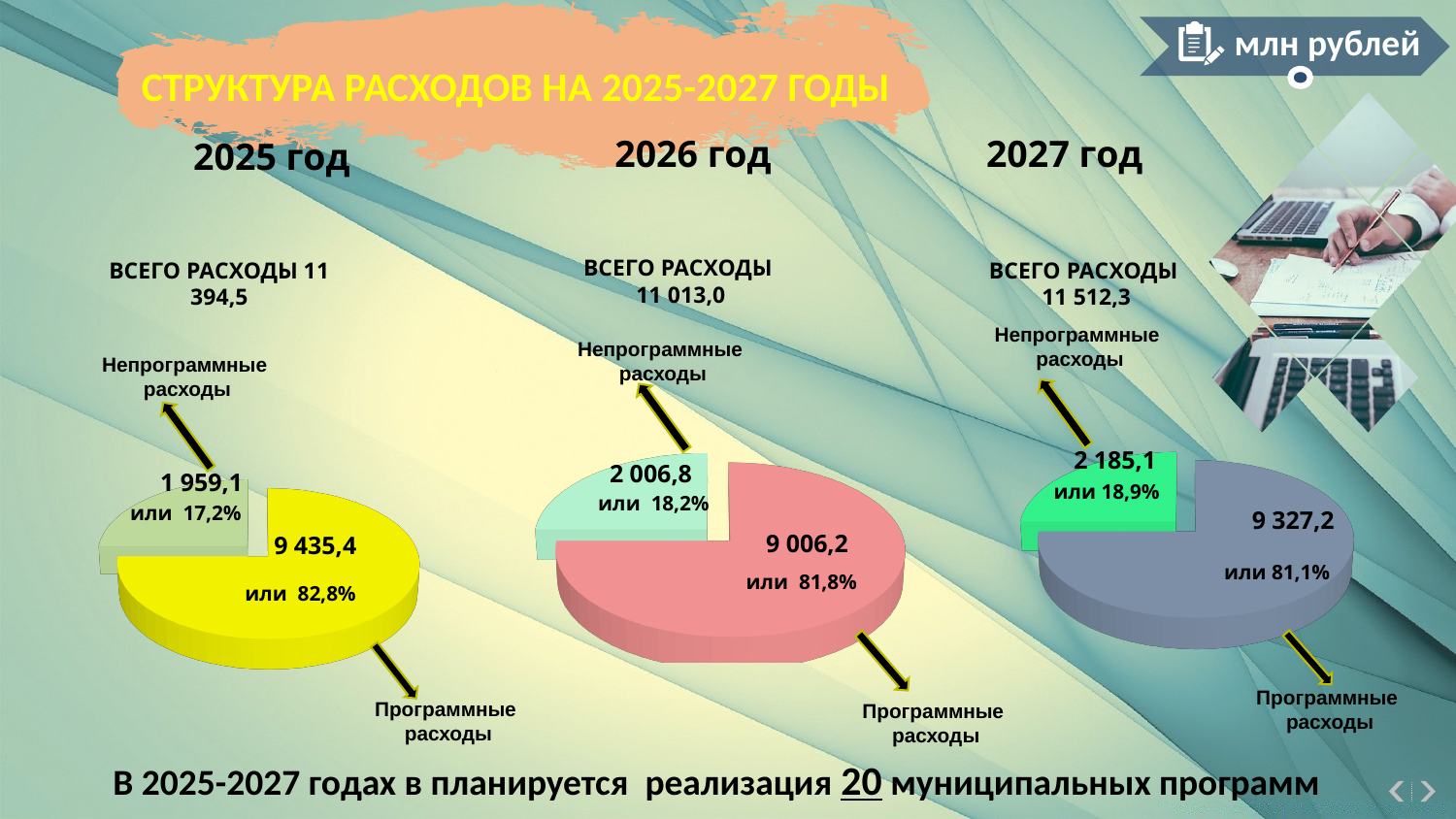
On the 2026 год chart, what is the difference between Программные расходы and Непрограммные расходы? 6 999,4 Which is larger: Непрограммные расходы on the 2025 год chart or Непрограммные расходы on the 2027 год chart? 2027 год What kind of chart is used for 2026 год? Pie chart On the 2025 год chart, what share of the pie is Непрограммные расходы? 17,2% On the 2025 год chart, what is the difference between Программные расходы and Непрограммные расходы? 7 476,3 On the 2027 год chart, what share of the pie is Программные расходы? 81,1% On the 2026 год chart, what is the value for Непрограммные расходы? 2 006,8 On the 2026 год chart, which slice is the largest? Программные расходы On the 2027 год chart, which slice is the smallest? Непрограммные расходы How many slices does the 2027 год chart have? 2 On the 2025 год chart, what is the value for Программные расходы? 9 435,4 On the 2027 год chart, what is the value for Программные расходы? 9 327,2